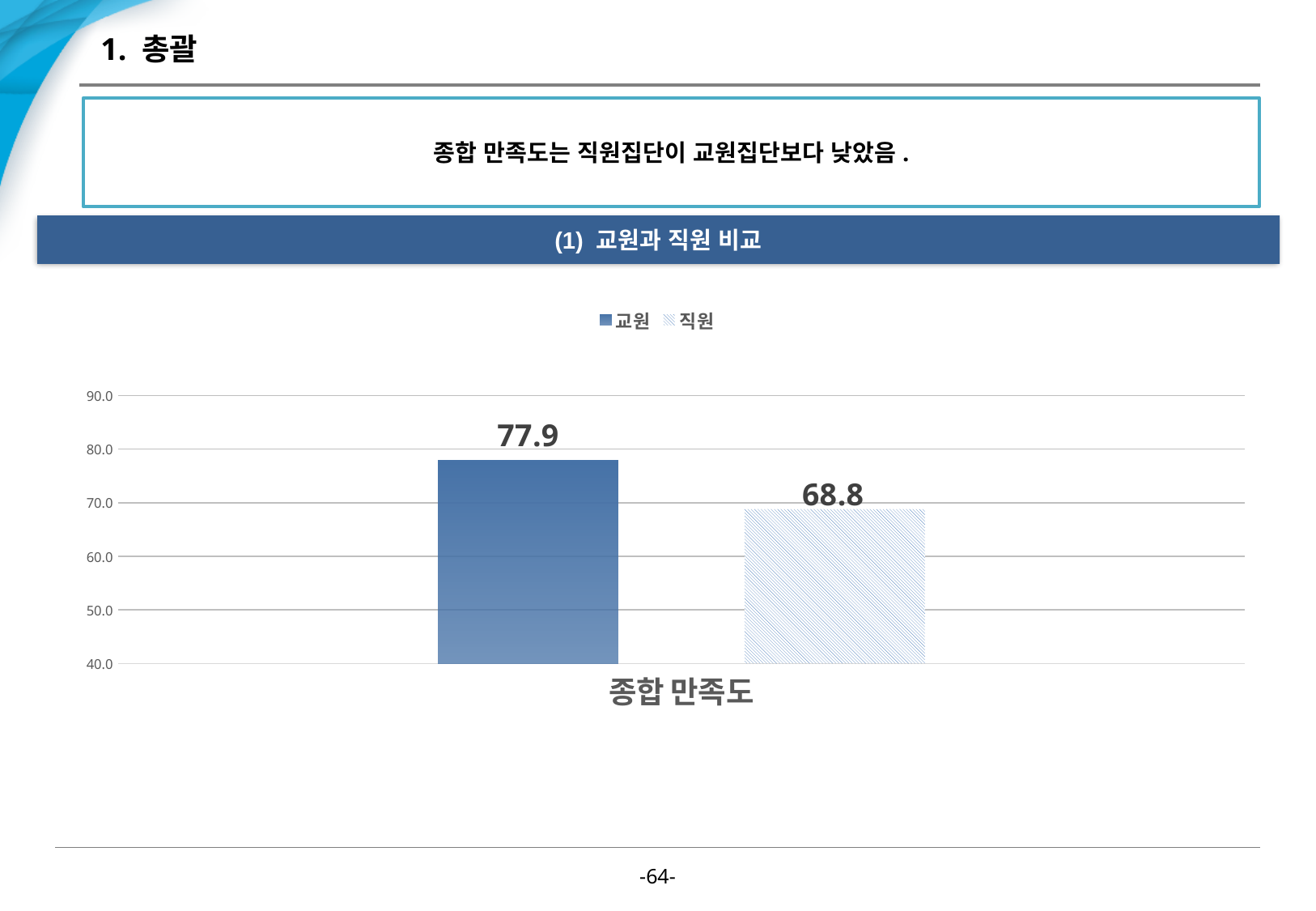
What is the difference between the 교원 value and the 직원 value for 종합 만족도? 9.1 What is the category label shown on the x axis of the chart? 종합 만족도 Which series has the lowest value in the chart? 직원 Which series has the higher value for 종합 만족도, 교원 or 직원? 교원 Is the value for 교원 greater or less than 70.0? greater What is the value for 교원 in the 종합 만족도 chart? 77.9 Which series has the highest value in the chart? 교원 Is the value for 직원 greater or less than 70.0? less How many series does the legend list? 2 What is the value for 직원 in the 종합 만족도 chart? 68.8 How many categories are shown on the x axis of the chart? 1 What kind of chart is shown on the slide? bar chart